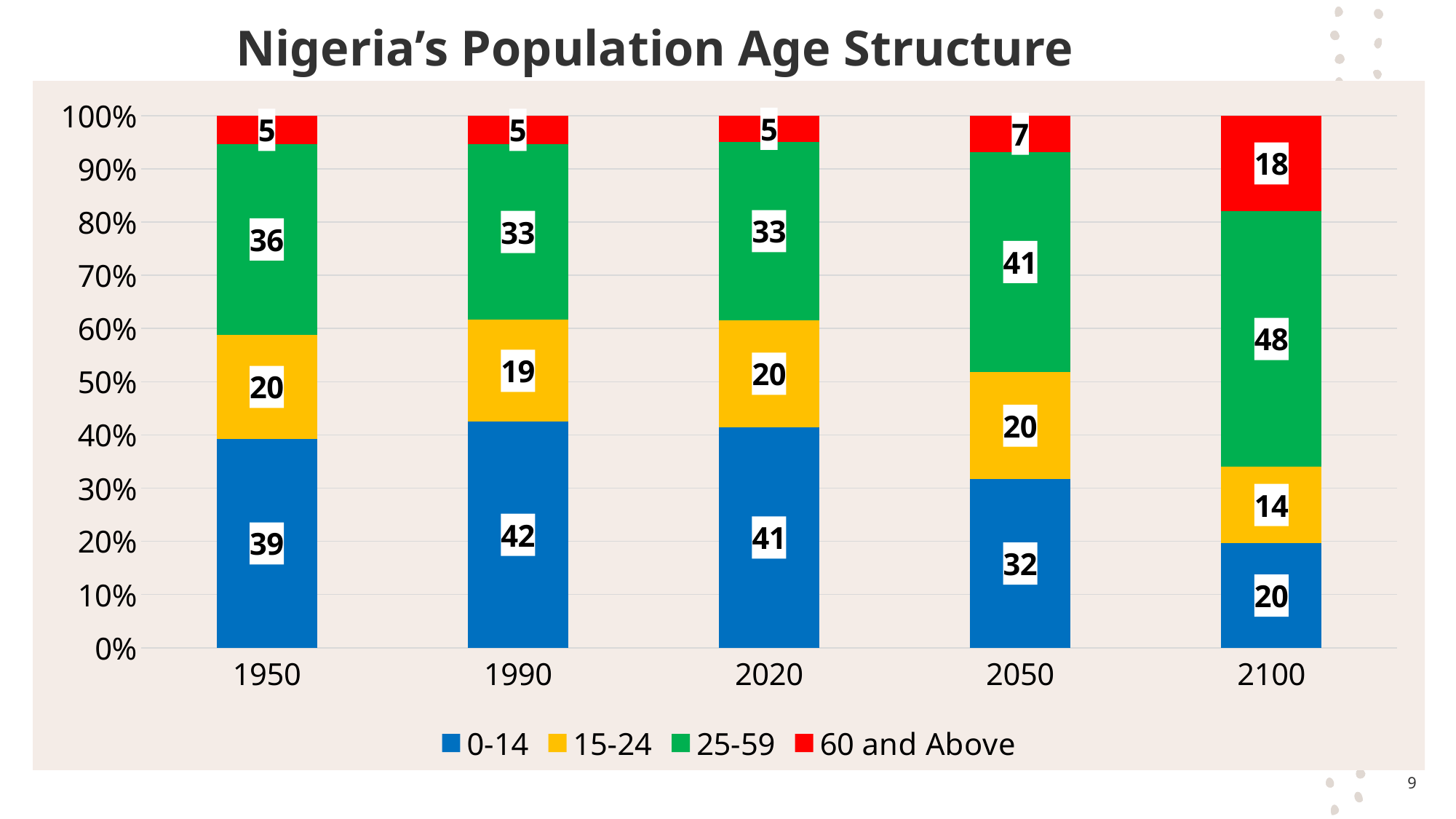
What is the value for the 0-14 age group in 1950? 39 In which year is the 0-14 age group value highest? 1990 How many years are shown on the x axis? 5 What colour represents the 25-59 age group? Green Does the 60 and Above value rise or fall from 1950 to 2100? Rise What is the difference between the 25-59 values for 2100 and 1950? 12 What is the value for the 60 and Above age group in 2100? 18 Which is larger, the 0-14 value in 2050 or the 0-14 value in 2100? 2050 In which year is the 15-24 age group value lowest? 2100 How many series does the legend list? 4 What is the value for the 25-59 age group in 2050? 41 What kind of chart is shown on the slide? Stacked bar chart